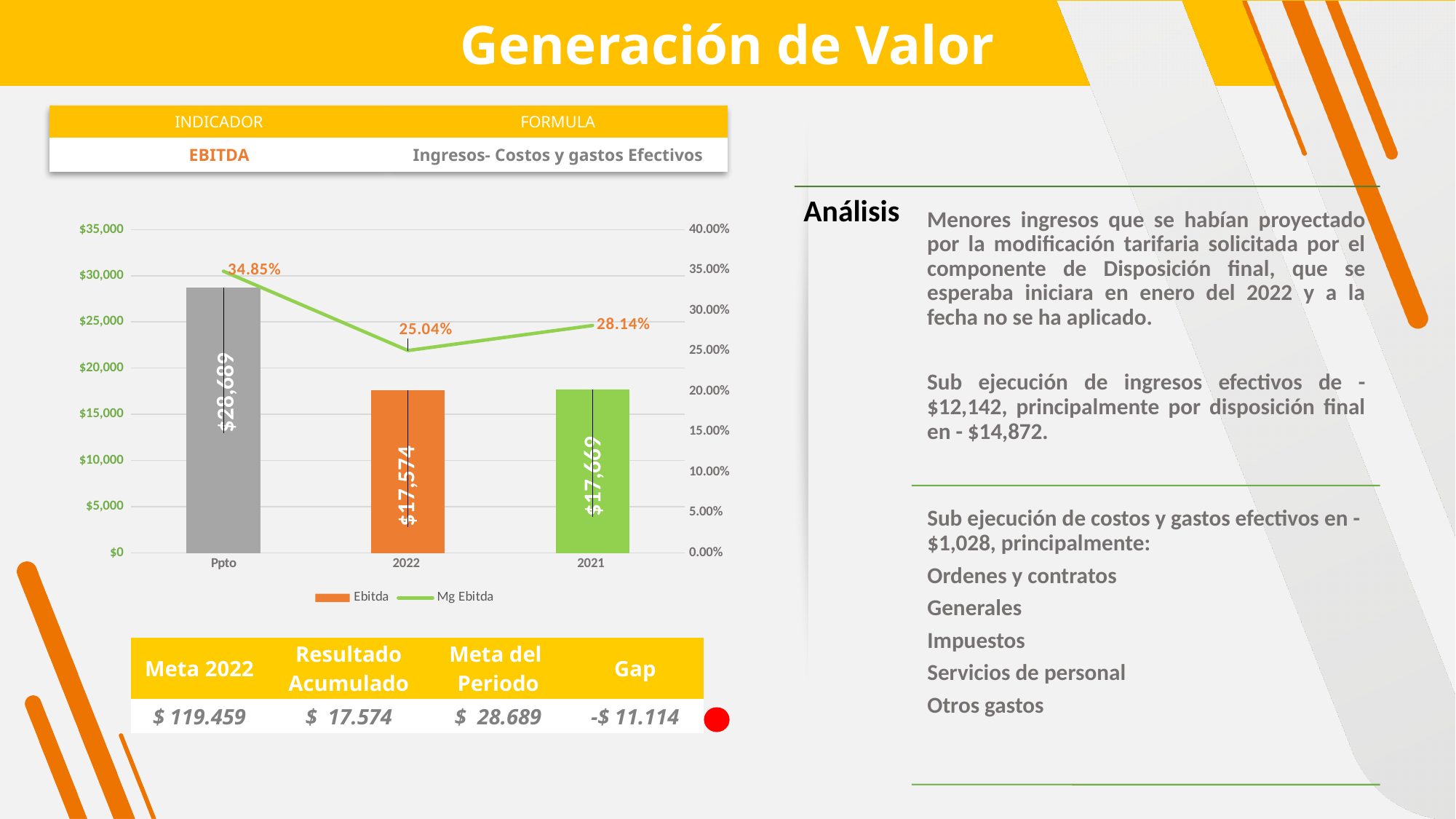
What is the Mg Ebitda value for 2022? 25.04% Is the Ebitda for Ppto larger or smaller than the Ebitda for 2022? larger What is the difference between the Ebitda for Ppto and the Ebitda for 2022? $11,115 What is the Ebitda value for 2021? $17,669 Which category has the highest Ebitda bar? Ppto What kind of chart is shown on the slide? Combined bar and line chart What is the Ebitda value for 2022? $17,574 What is the Ebitda value for Ppto? $28,689 What is the Mg Ebitda value for 2021? 28.14% What is the Mg Ebitda value for Ppto? 34.85% Which category has the lowest Mg Ebitda value? 2022 How many series does the chart legend list? 2